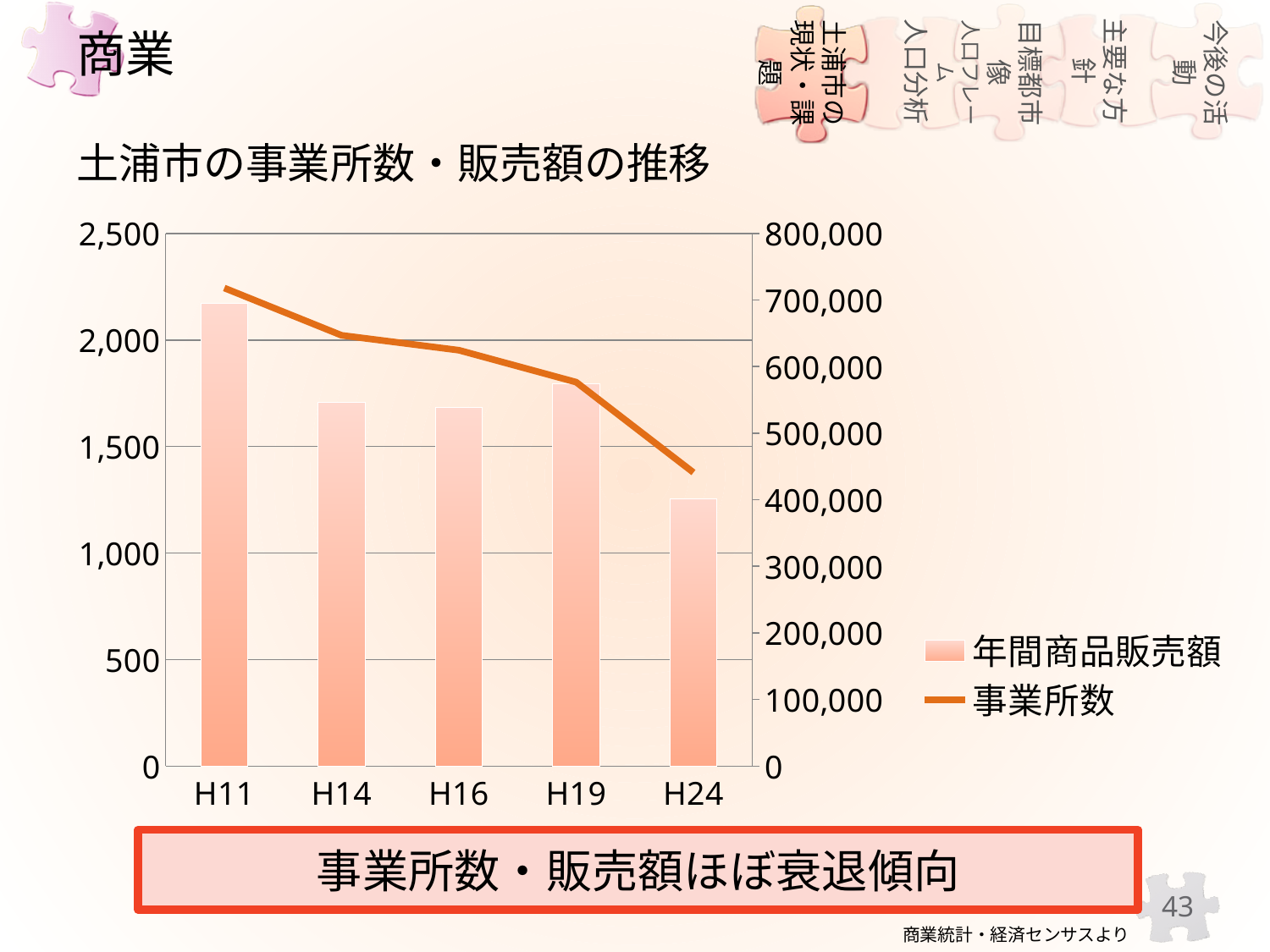
Which series is drawn as a line in the chart? 事業所数 Is the 年間商品販売額 value for H11 greater or less than 600,000 on the right axis? greater How many series does the chart legend list? 2 Which series is drawn as bars in the chart? 年間商品販売額 Is the 年間商品販売額 value for H24 greater or less than 500,000 on the right axis? less In which year is the 年間商品販売額 bar the lowest? H24 How many years are shown on the x axis of the chart? 5 Does the 事業所数 line rise or fall from H11 to H24? fall In which year is the 事業所数 line at its highest point? H11 Is the 事業所数 value for H24 greater or less than 1,500 on the left axis? less What kind of chart is shown on the slide? A combined bar and line chart In which year is the 年間商品販売額 bar the highest? H11